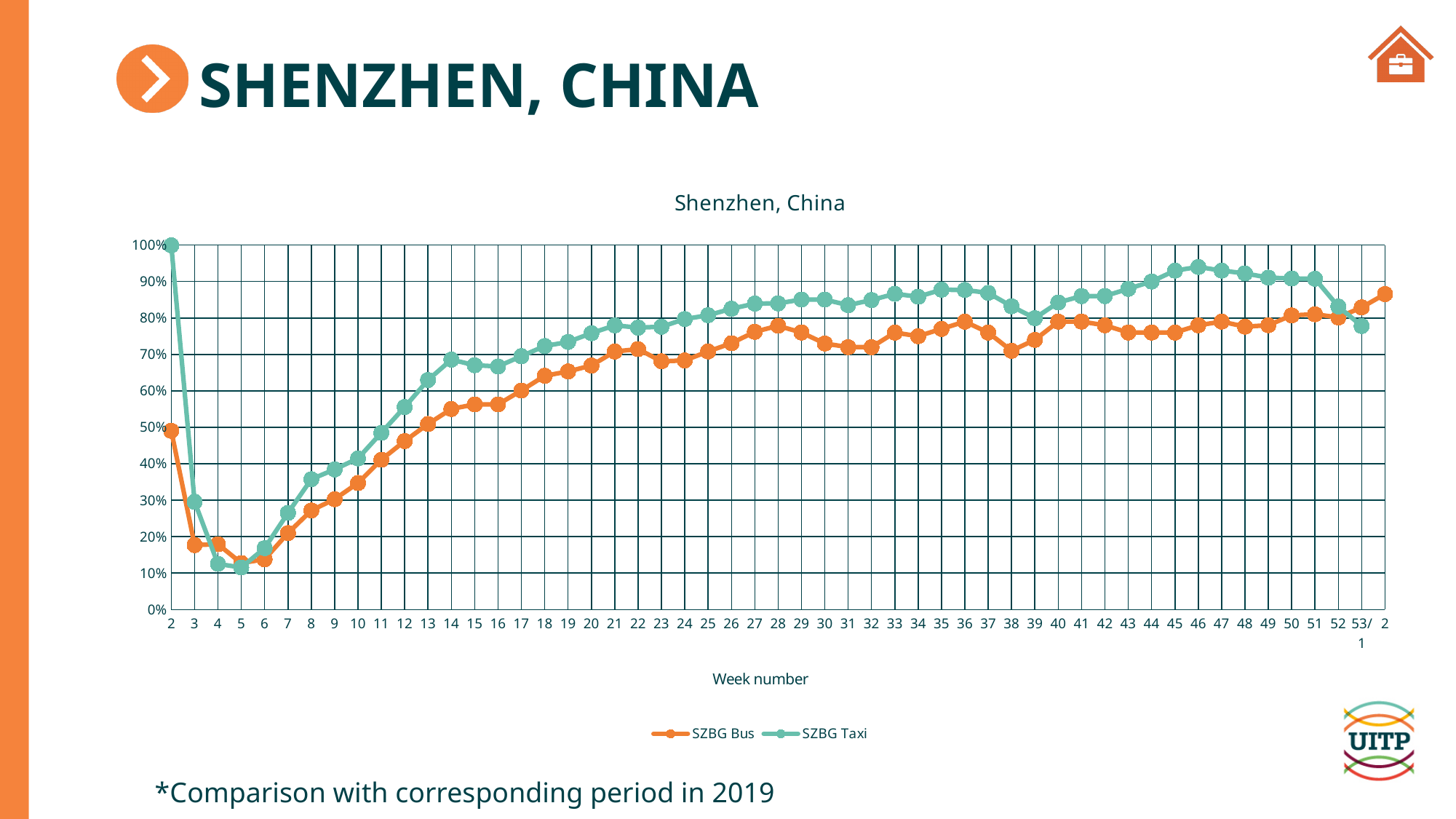
How many series does the legend list? 2 At week 3, which series has the higher value, SZBG Bus or SZBG Taxi? SZBG Taxi Is the value for SZBG Bus at week 28 greater or less than 70%? greater What is the title of the x axis? Week number What are the two series named in the legend? SZBG Bus and SZBG Taxi Between week 5 and week 28, does the SZBG Bus series generally rise or fall? rise At which week does the SZBG Taxi series reach its highest value? Week 2 What kind of chart is shown on the slide? line chart Is the value for SZBG Taxi at week 14 greater or less than 60%? greater At week 46, which series has the higher value, SZBG Bus or SZBG Taxi? SZBG Taxi Is the value for SZBG Bus at week 38 greater or less than 80%? less